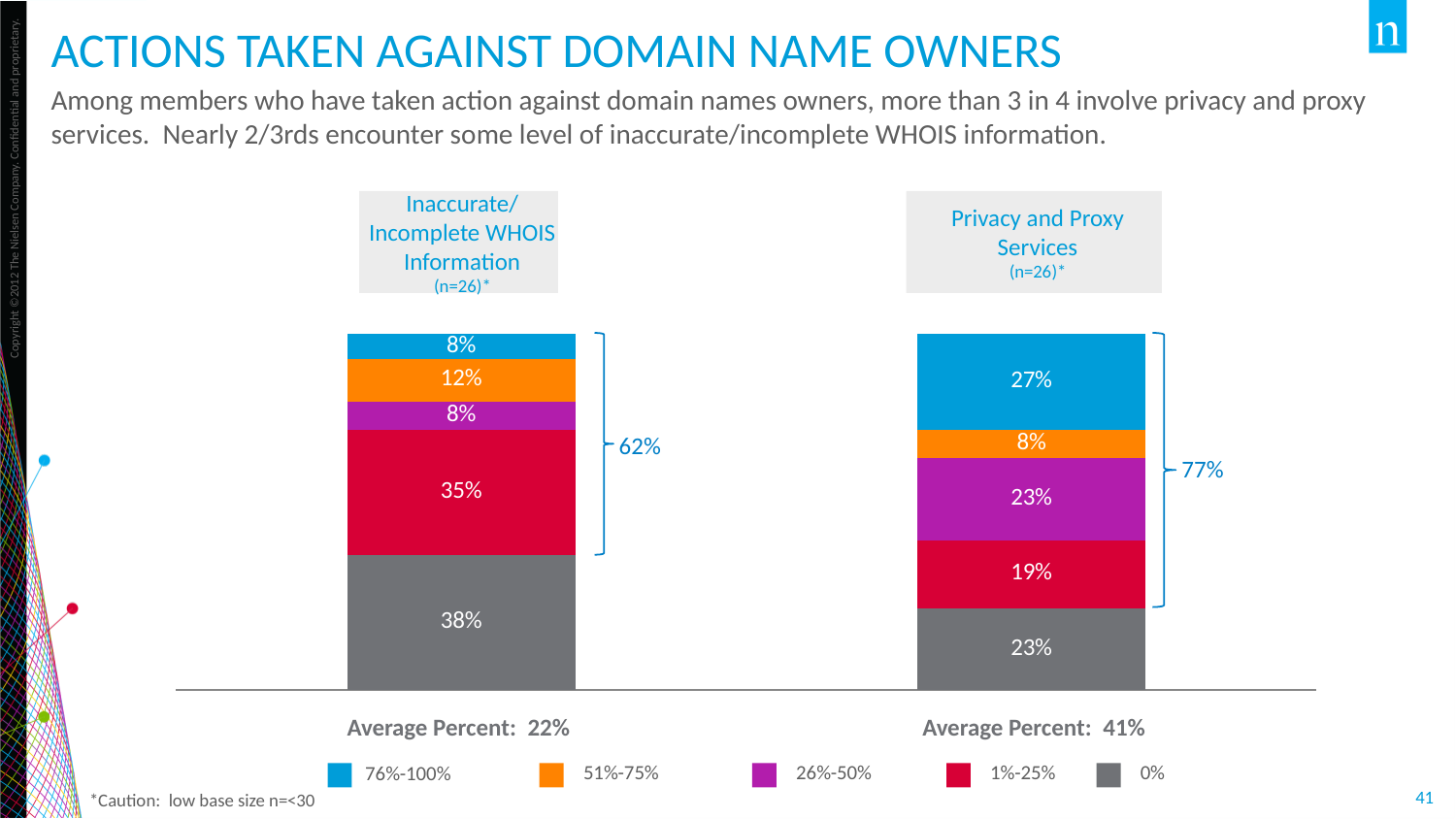
What is the value of the 51%-75% segment for Inaccurate/Incomplete WHOIS Information? 12% What kind of chart is shown on the slide? stacked bar chart What is the difference between the 1%-25% segments of Inaccurate/Incomplete WHOIS Information and Privacy and Proxy Services? 16% What is the value of the 0% segment for Inaccurate/Incomplete WHOIS Information? 38% What is the value of the 76%-100% segment for Privacy and Proxy Services? 27% How many series does the legend list? 5 How many bars (categories) are plotted in the chart? 2 Which segment is the largest in the Inaccurate/Incomplete WHOIS Information bar? 0% What is the Average Percent shown for Privacy and Proxy Services? 41% Which segment is the smallest in the Privacy and Proxy Services bar? 51%-75% What is the value of the 1%-25% segment for Privacy and Proxy Services? 19% Which bar has the larger 26%-50% segment, Inaccurate/Incomplete WHOIS Information or Privacy and Proxy Services? Privacy and Proxy Services